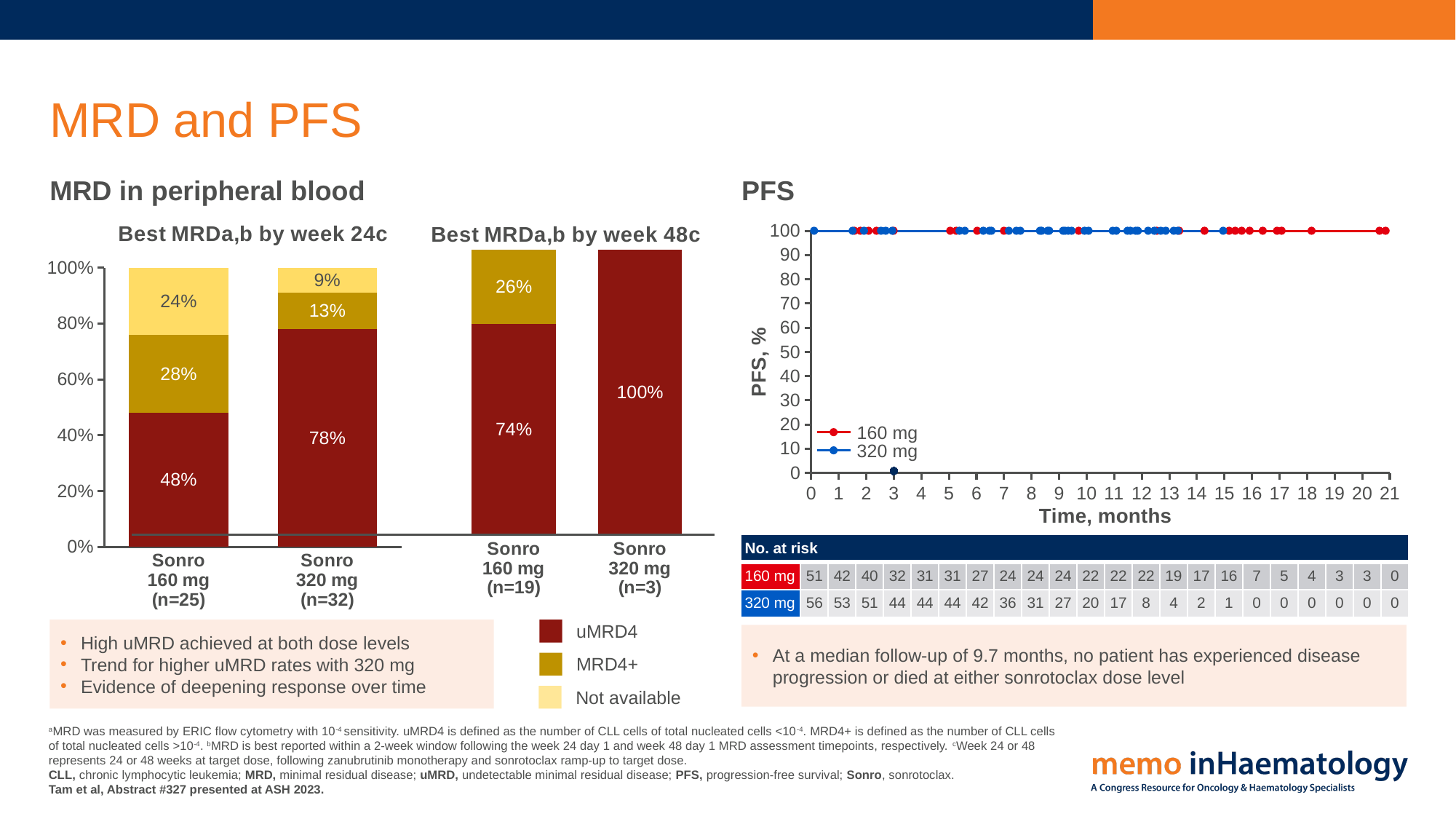
In the 'Best MRDa,b by week 48c' chart, what is the MRD4+ value for Sonro 160 mg? 26% In the 'Best MRDa,b by week 24c' chart, what is the uMRD4 value for Sonro 160 mg (n=25)? 48% In the 'Best MRDa,b by week 48c' chart, what is the uMRD4 value for Sonro 320 mg (n=3)? 100% What kind of chart is used for the MRD in peripheral blood data? Stacked bar chart In the 'Best MRDa,b by week 24c' chart, what is the 'Not available' share for Sonro 160 mg? 24% In the 'Best MRDa,b by week 24c' chart, what is the MRD4+ value for Sonro 320 mg? 13% In the 'Best MRDa,b by week 48c' chart, which dose group has the higher uMRD4 value? Sonro 320 mg (n=3) In the 'Best MRDa,b by week 48c' chart, what is the uMRD4 value for Sonro 160 mg (n=19)? 74% In the PFS chart, what is the number at risk for the 160 mg group at time 0? 51 In the 'Best MRDa,b by week 24c' chart, what is the difference in uMRD4 between Sonro 320 mg and Sonro 160 mg? 30% How many series does the legend of the PFS chart list? 2 In the 'Best MRDa,b by week 24c' chart, what is the uMRD4 value for Sonro 320 mg (n=32)? 78%